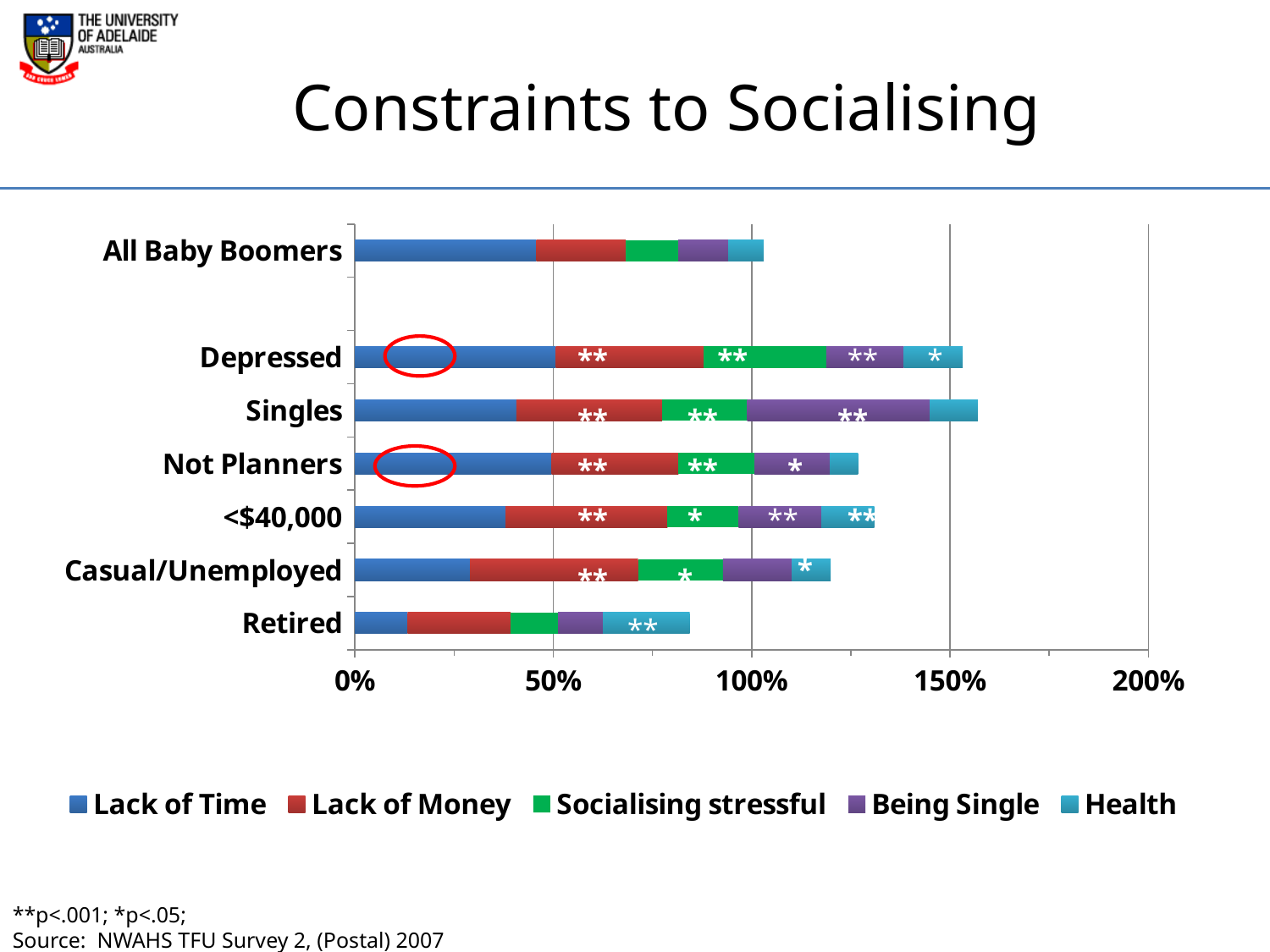
Is the total stacked bar for Depressed greater or less than 150%? greater Is the total stacked bar for Retired greater or less than 100%? less Which group has the shortest total stacked bar? Retired How many categories (groups) are plotted on the chart? 7 How many series does the legend list? 5 Is the Lack of Time segment for Retired greater or less than 50%? less Which has the larger total stacked bar, Retired or Casual/Unemployed? Casual/Unemployed Which has the larger Lack of Time segment, Retired or Depressed? Depressed What is the title of the chart on the slide? Constraints to Socialising What kind of chart is shown on the slide? Stacked bar chart